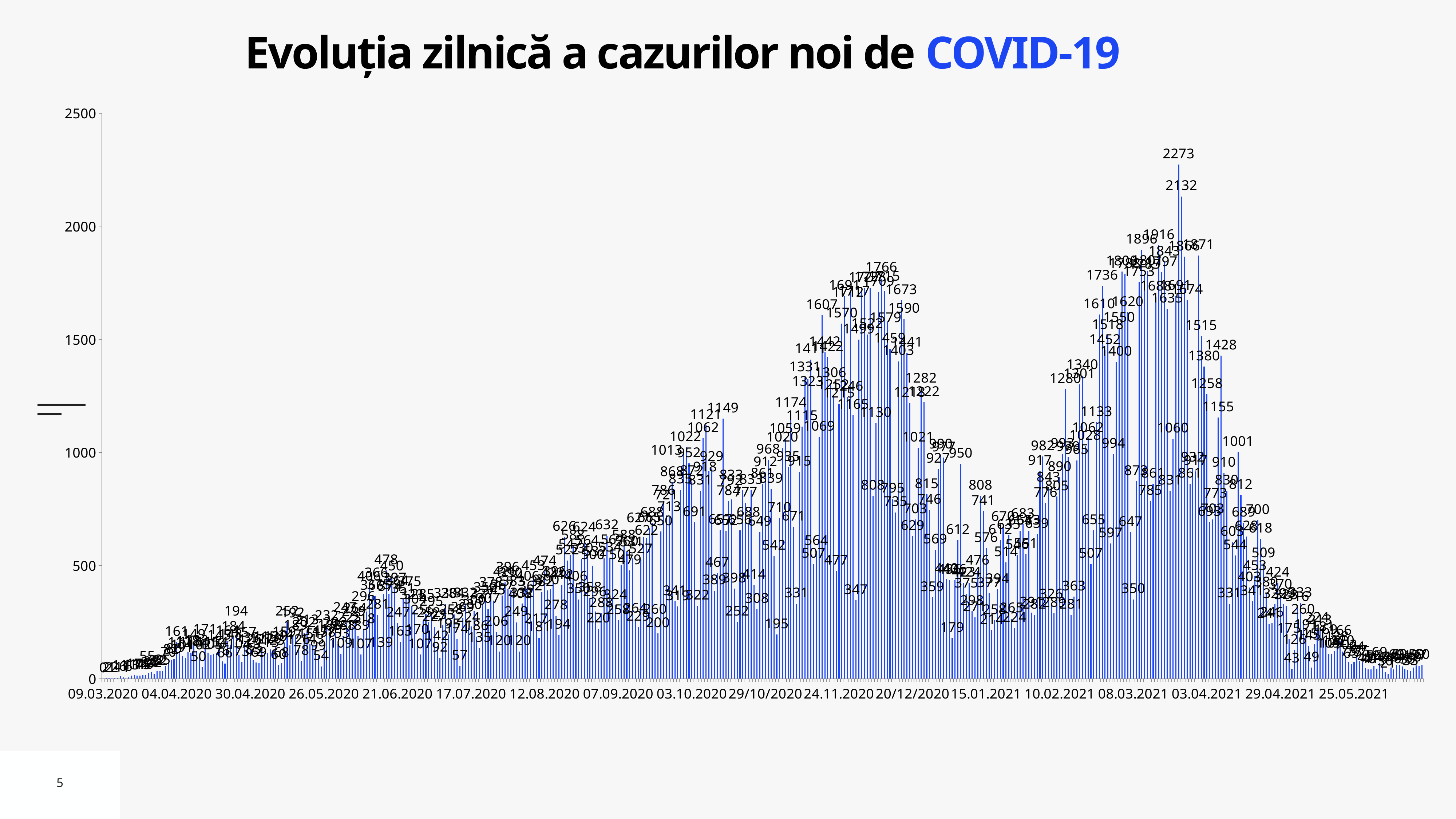
What is the title of the chart? Evoluția zilnică a cazurilor noi de COVID-19 Is the highest bar on the chart greater or less than 2000? greater What is the first date label on the horizontal axis? 09.03.2020 What is the last date label on the horizontal axis? 25.05.2021 What is the difference between the two highest labelled values, 2273 and 2132? 141 What is the maximum value shown on the vertical axis? 2500 What kind of chart is shown on the slide? Bar chart What is the highest labelled value in the late-2020 wave (around 24.11.2020)? 1766 What is the highest daily value labelled on the chart? 2273 Which is larger: the peak of the late-2020 wave (1766) or the peak of the spring 2021 wave (2273)? The spring 2021 peak (2273) What is the second-highest daily value labelled on the chart, next to the 2273 peak? 2132 Do the values rise or fall along the x axis between 03.04.2021 and 25.05.2021? fall